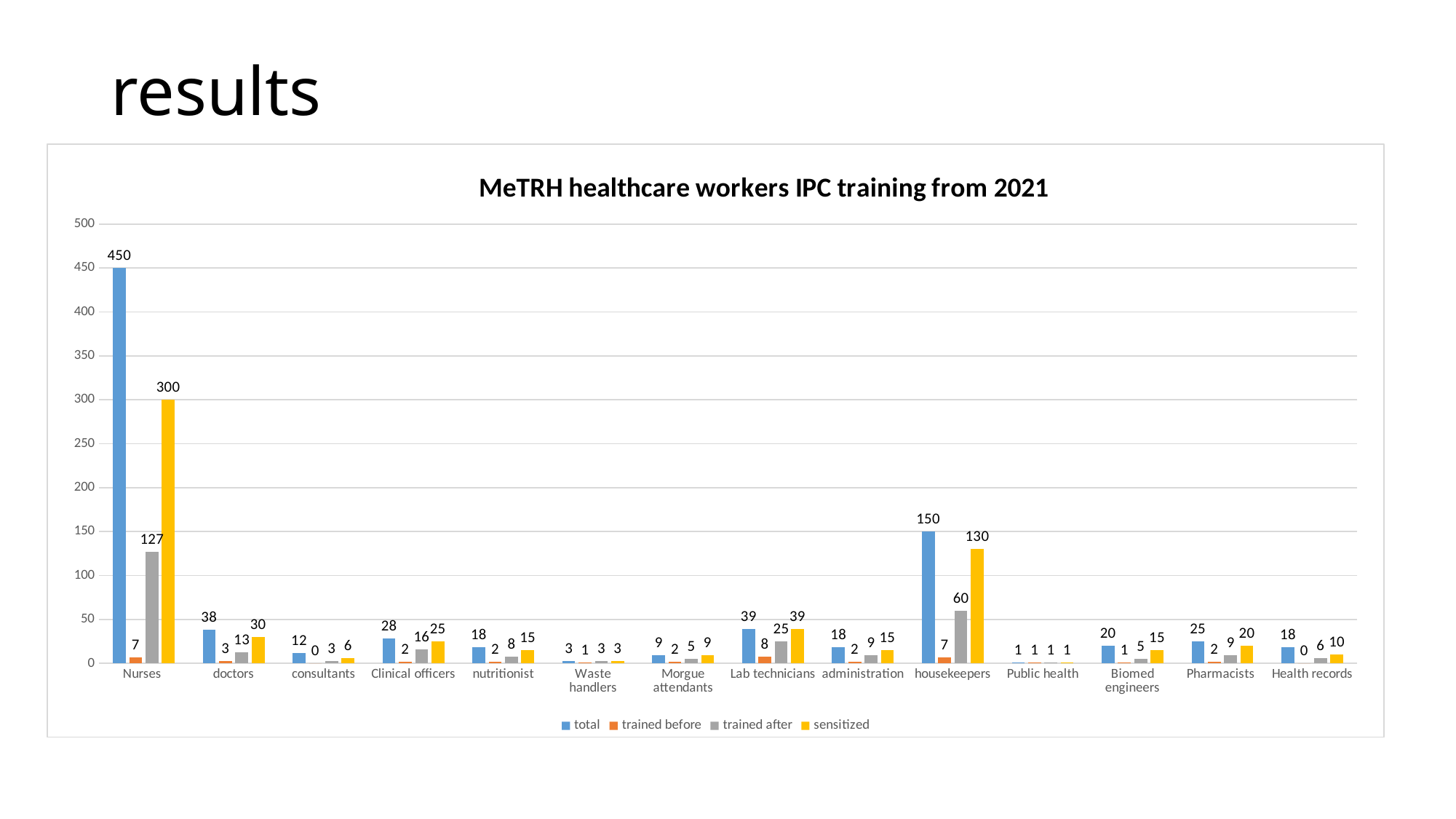
How many Lab technicians were trained after? 25 How many categories are shown on the x axis? 14 What is the difference between the total for Nurses and the number of Nurses sensitized? 150 Which category has the highest total value? Nurses How many consultants were trained before? 0 How many housekeepers were sensitized? 130 How many series does the legend list? 4 Which category has the lowest total value? Public health Which is larger: the number of housekeepers trained after or the number of Nurses trained after? Nurses trained after What kind of chart is shown on the slide? Bar chart What is the total number of Nurses shown in the chart? 450 What is the title of the chart? MeTRH healthcare workers IPC training from 2021